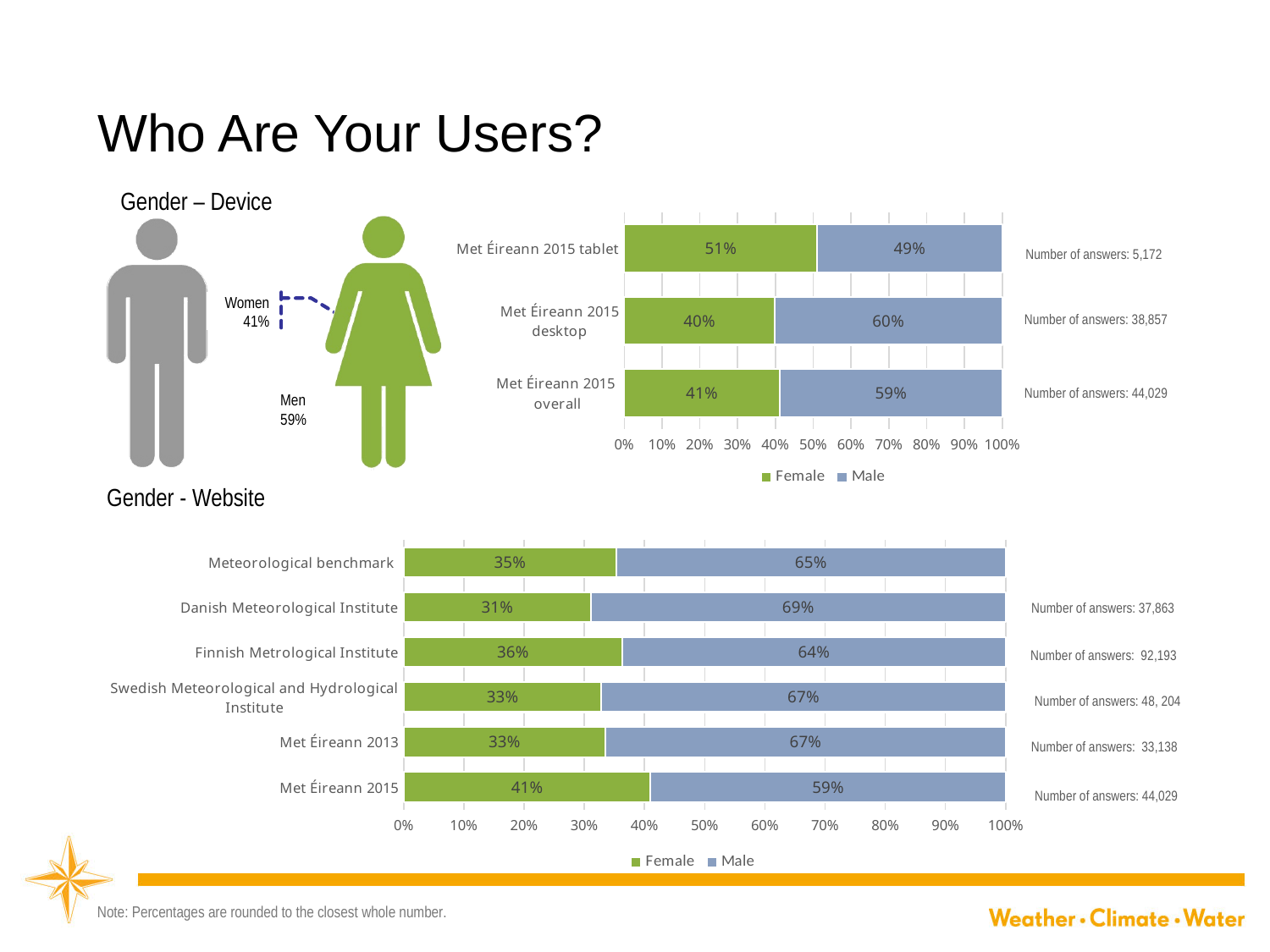
How many series does the legend of the Gender - Website chart list? 2 In the Gender - Website chart, how many categories are plotted? 6 In the Gender - Website chart, what is the Female percentage for the Danish Meteorological Institute? 31% In the Gender – Device chart, what is the Male percentage for Met Éireann 2015 desktop? 60% In the Gender – Device chart, how many categories are plotted? 3 In the Gender - Website chart, which category has the highest Female percentage? Met Éireann 2015 In the Gender – Device chart, what is the Female percentage for Met Éireann 2015 tablet? 51% In the Gender – Device chart, which category has the highest Female percentage? Met Éireann 2015 tablet In the Gender - Website chart, which category has the lowest Female percentage? Danish Meteorological Institute In the Gender – Device chart, what is the difference between the Male and Female percentages for Met Éireann 2015 overall? 18% In the Gender - Website chart, is the Female percentage for Met Éireann 2013 larger or smaller than for Met Éireann 2015? smaller In the Gender - Website chart, what is the Male percentage for the Finnish Metrological Institute? 64%